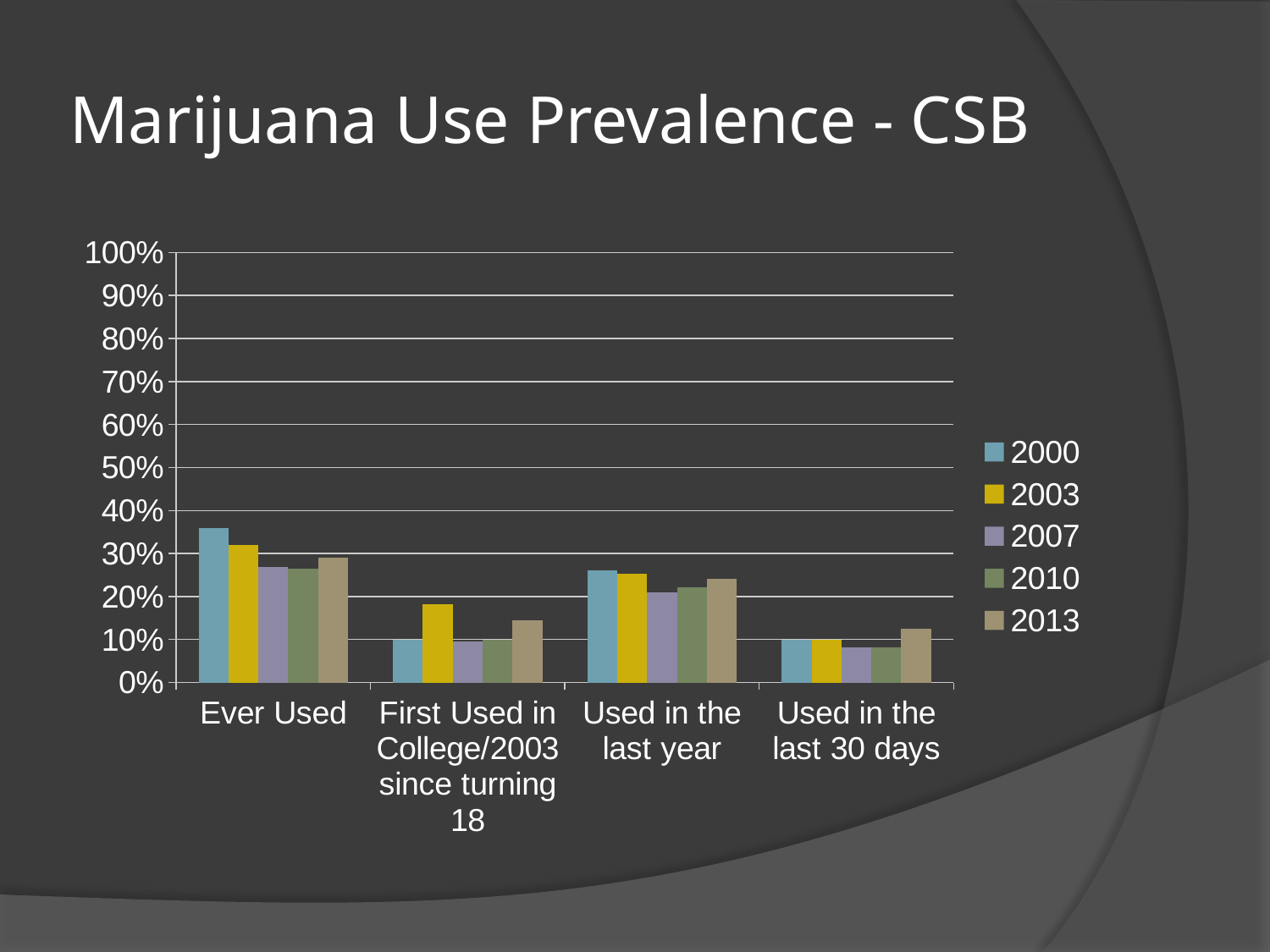
In the Ever Used category, which is larger: the value for 2000 or the value for 2003? 2000 In the Used in the last year category, which is larger: the value for 2000 or the value for 2007? 2000 What kind of chart is shown on the slide? bar chart Is the value for 2007 in the Used in the last year category greater or less than 30%? less Which year has the highest value in the First Used in College/2003 since turning 18 category? 2003 Which year has the highest value in the Used in the last 30 days category? 2013 How many categories are shown on the x axis? 4 Which year has the highest value in the Ever Used category? 2000 How many series does the legend list? 5 Is the value for 2003 in the First Used in College/2003 since turning 18 category greater or less than 20%? less Is the value for 2000 in the Ever Used category greater or less than 30%? greater What is the title of the slide containing the chart? Marijuana Use Prevalence - CSB